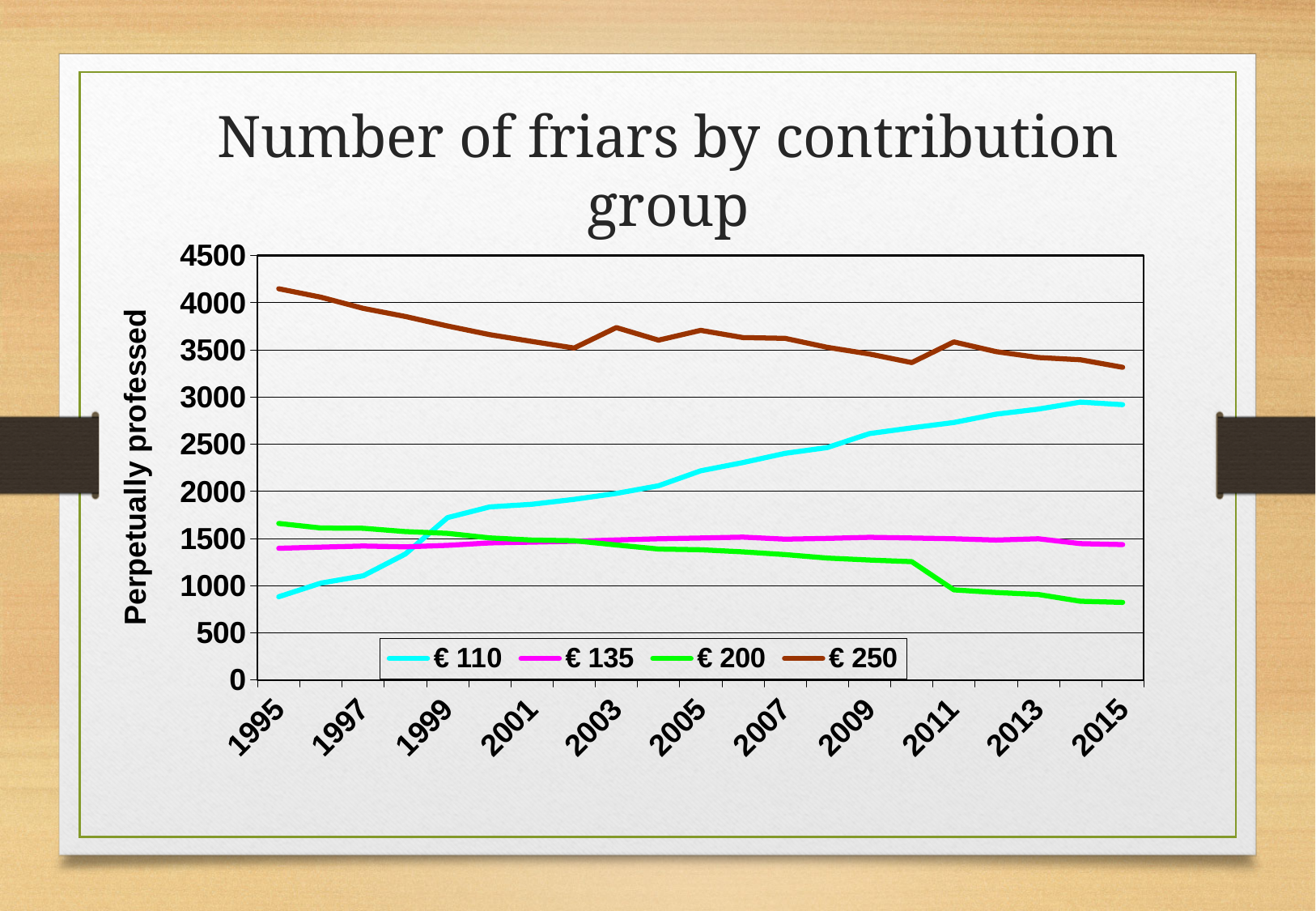
Which series has the highest value in 2015? € 250 Is the value for € 250 in 1995 greater or less than 4000? greater Does the € 110 series rise or fall from 1995 to 2015? rise Is the value for € 250 in 2015 greater or less than 3500? less Does the € 250 series rise or fall from 1995 to 2015? fall What kind of chart is shown on the slide? line chart Is the value for € 110 in 2005 greater or less than 2000? greater In 1995, which is larger: the value for € 200 or the value for € 110? € 200 What is the title of the chart? Number of friars by contribution group What is the label on the vertical axis? Perpetually professed How many series does the legend list? 4